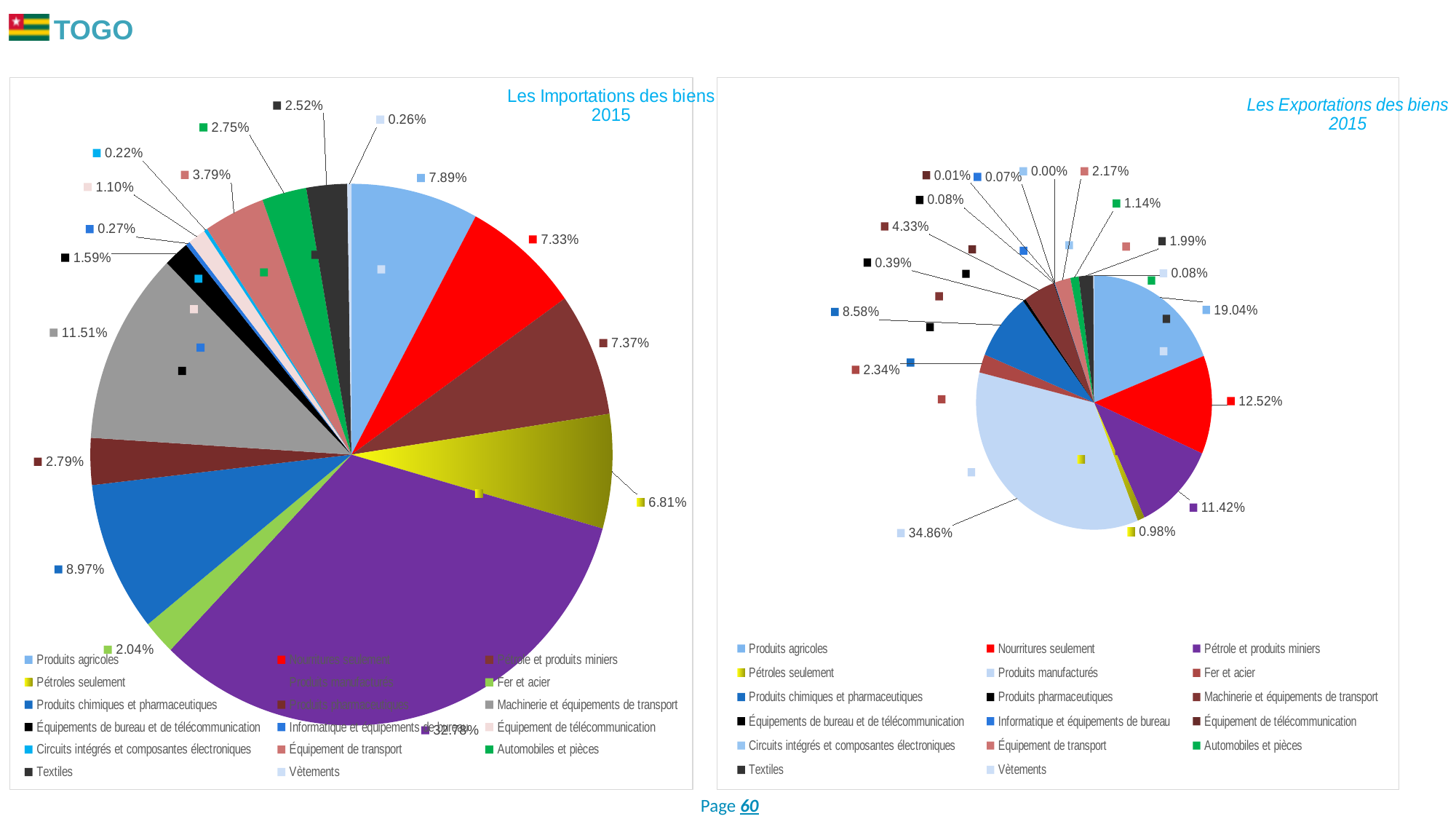
In the 'Les Exportations des biens 2015' chart, what is the share of Pétrole et produits miniers? 11.42% In the 'Les Exportations des biens 2015' chart, which category has the largest share? Produits manufacturés How many categories are listed in the legend of the 'Les Exportations des biens 2015' chart? 17 In the 'Les Exportations des biens 2015' chart, what is the share of Produits agricoles? 19.04% In the 'Les Importations des biens 2015' chart, which category has the smallest share? Circuits intégrés et composantes électroniques What kind of chart is used on this slide for 'Les Importations des biens 2015'? Pie chart In the 'Les Exportations des biens 2015' chart, what is the difference between the shares of Produits agricoles and Nourritures seulement? 6.52 percentage points In the 'Les Importations des biens 2015' chart, what is the share of Machinerie et équipements de transport? 11.51% In the 'Les Importations des biens 2015' chart, which is larger: Produits chimiques et pharmaceutiques or Produits agricoles? Produits chimiques et pharmaceutiques In the 'Les Importations des biens 2015' chart, which category has the largest share? Produits manufacturés In the 'Les Importations des biens 2015' chart, what is the share of Pétroles seulement? 6.81% In the 'Les Importations des biens 2015' chart, what is the share of Produits manufacturés? 32.78%